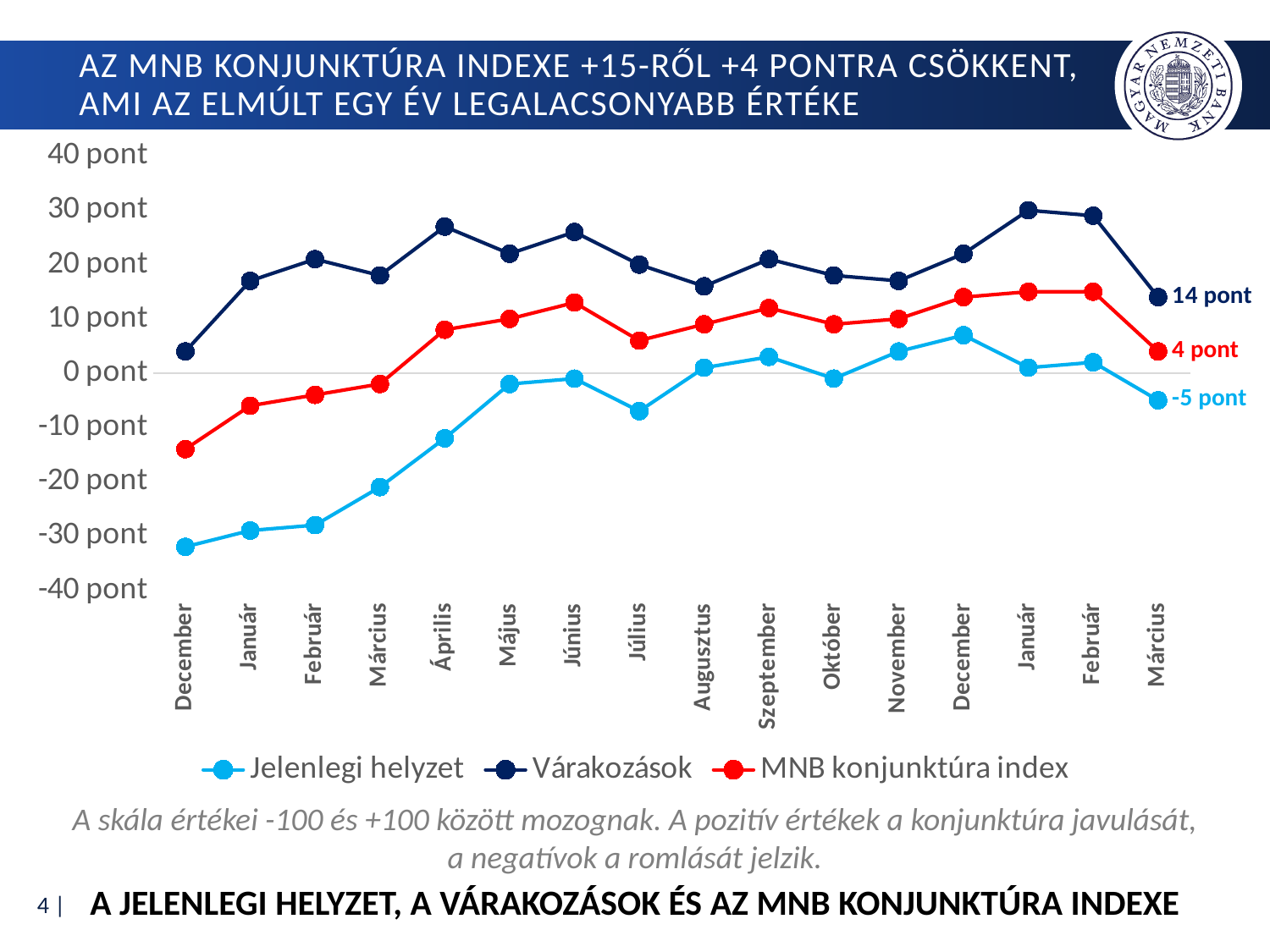
Is the value of Jelenlegi helyzet at the first December point greater or less than -30 pont? less How many months are shown on the x axis? 16 Does the Jelenlegi helyzet series rise or fall from the first December to Június? rise How many series does the legend list? 3 At the final Március point, what is the difference between the MNB konjunktúra index value and the Jelenlegi helyzet value? 9 pont Is the value of Várakozások at Április greater or less than 20 pont? greater What kind of chart is shown on the slide? line chart What is the value of the Jelenlegi helyzet series at the final Március point? -5 pont At the final Március point, which series has the higher value: Várakozások or Jelenlegi helyzet? Várakozások At the final Március point, what is the difference between the Várakozások value and the MNB konjunktúra index value? 10 pont What is the value of the Várakozások series at the final Március point? 14 pont What is the value of the MNB konjunktúra index series at the final Március point? 4 pont